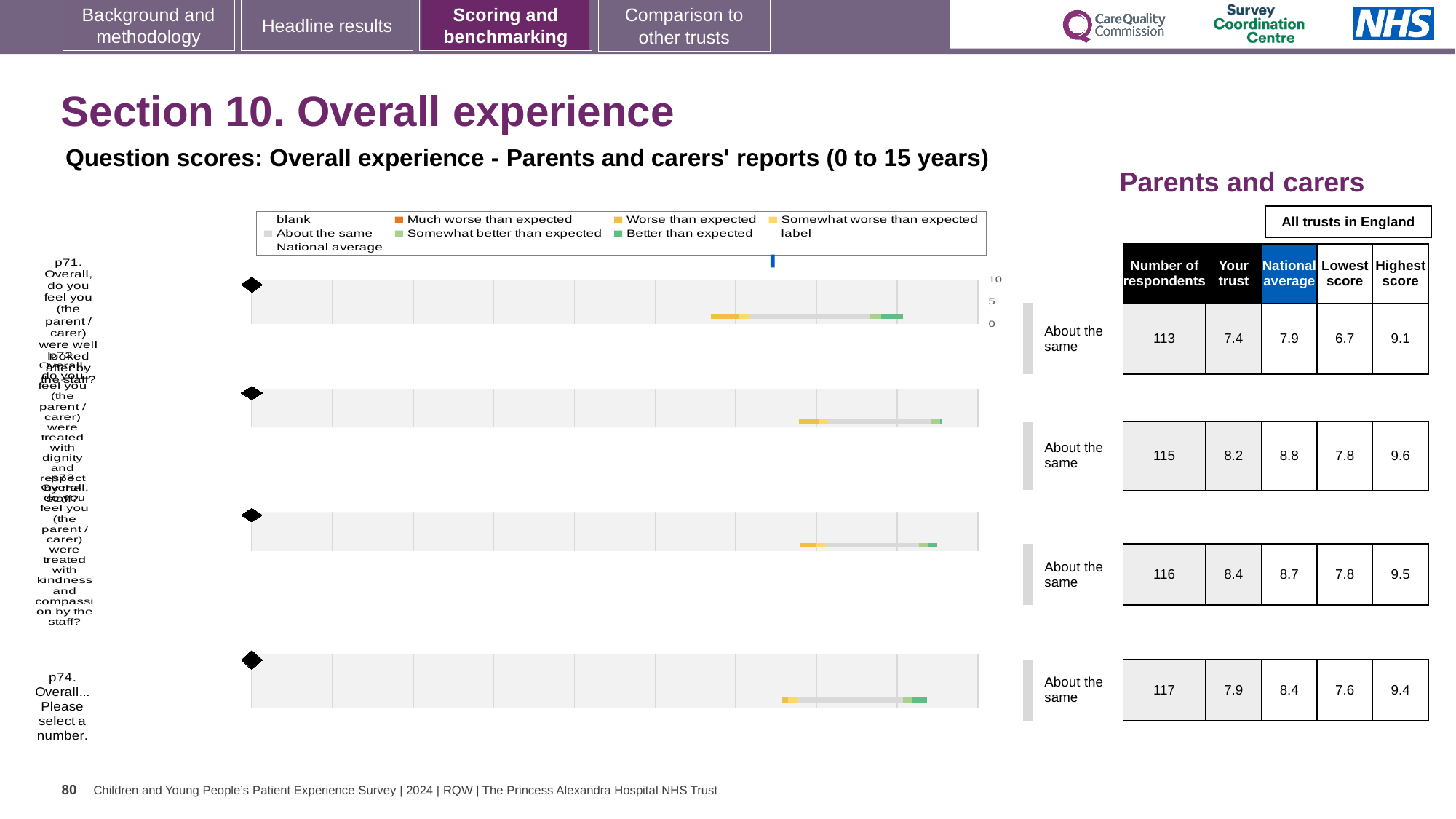
How many questions (rows) are plotted in the Overall experience chart? 4 In the table beside the chart, is the 'Your trust' score for p74 larger or smaller than the national average for p74? smaller What is the title of the chart on this slide? Question scores: Overall experience - Parents and carers' reports (0 to 15 years) In the table beside the chart, what is the difference between the national average and the 'Your trust' score for p72? 0.6 In the table beside the chart, what is the 'Your trust' score for p71 (were you well looked after by the staff)? 7.4 In the table beside the chart, which question has the lowest 'Your trust' score? p71 In the table beside the chart, what is the national average for p74 (Overall... Please select a number)? 8.4 Which legend entry is shown in orange in the Overall experience chart? Much worse than expected In the table beside the chart, how many respondents answered p73 (treated with kindness and compassion)? 116 What kind of chart is used to show the question scores for Overall experience? bar chart In the table beside the chart, which question has the highest 'Your trust' score? p73 How many entries does the legend of the Overall experience chart list? 9